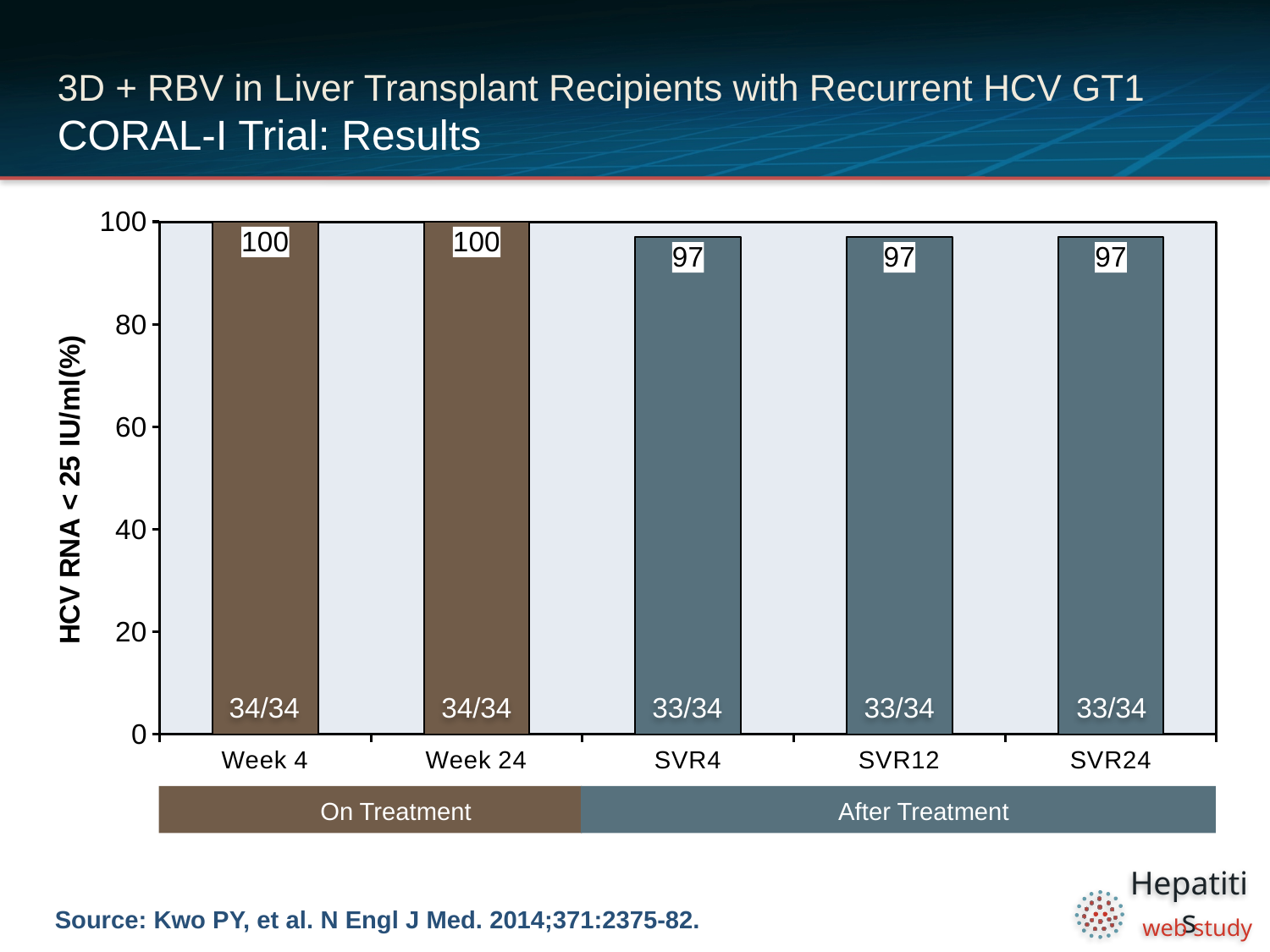
What is the difference between the Week 24 value and the SVR4 value? 3 Which is larger, the value for Week 4 or the value for SVR12? Week 4 What is the value for SVR12? 97 What kind of chart is shown on the slide? Bar chart What fraction of patients is shown for the SVR4 bar? 33/34 What is the value for Week 4? 100 Which categories fall under the 'On Treatment' band below the x axis? Week 4 and Week 24 What fraction of patients is shown for the Week 24 bar? 34/34 How many categories are shown on the x axis? 5 What is the value for SVR24? 97 What is the y-axis label of the chart? HCV RNA < 25 IU/ml(%) Is the value for SVR24 greater or less than 80? greater